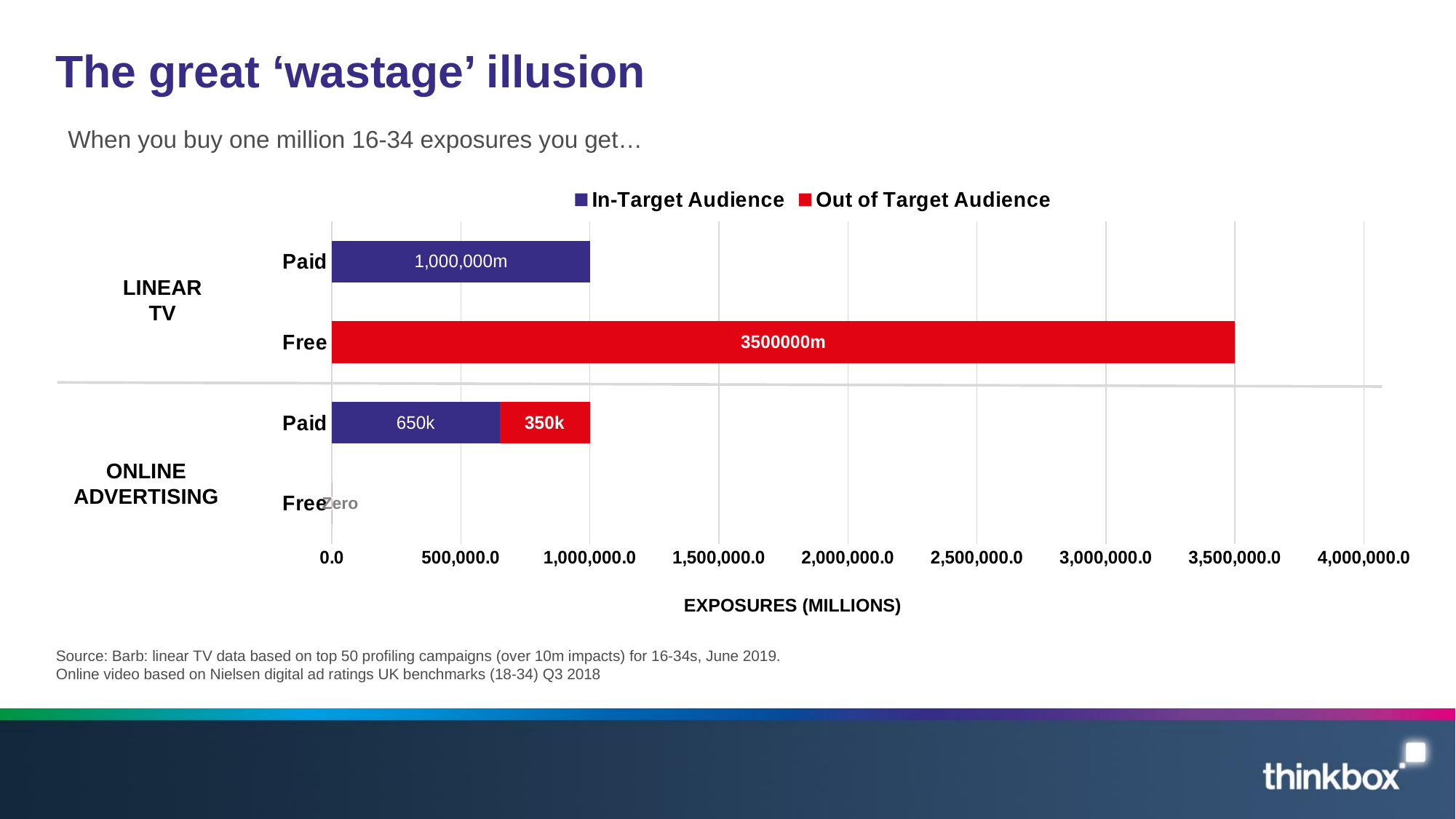
What is the Out of Target Audience value for Online Advertising Paid? 350k What is the In-Target Audience value for Online Advertising Paid? 650k How many series does the chart legend list? 2 Which bar is the longest in the chart? Linear TV Free What is the Out of Target Audience value for Linear TV Free? 3500000m Is the Linear TV Free value greater or less than 3,000,000.0? greater For Online Advertising Paid, which is larger: the In-Target Audience or the Out of Target Audience? In-Target Audience What is the difference between the In-Target Audience and Out of Target Audience values for Online Advertising Paid? 300k What is the In-Target Audience value for Linear TV Paid? 1,000,000m What is the title of the horizontal axis? EXPOSURES (MILLIONS) What value is labelled for Online Advertising Free? Zero What type of chart is shown on the slide? bar chart